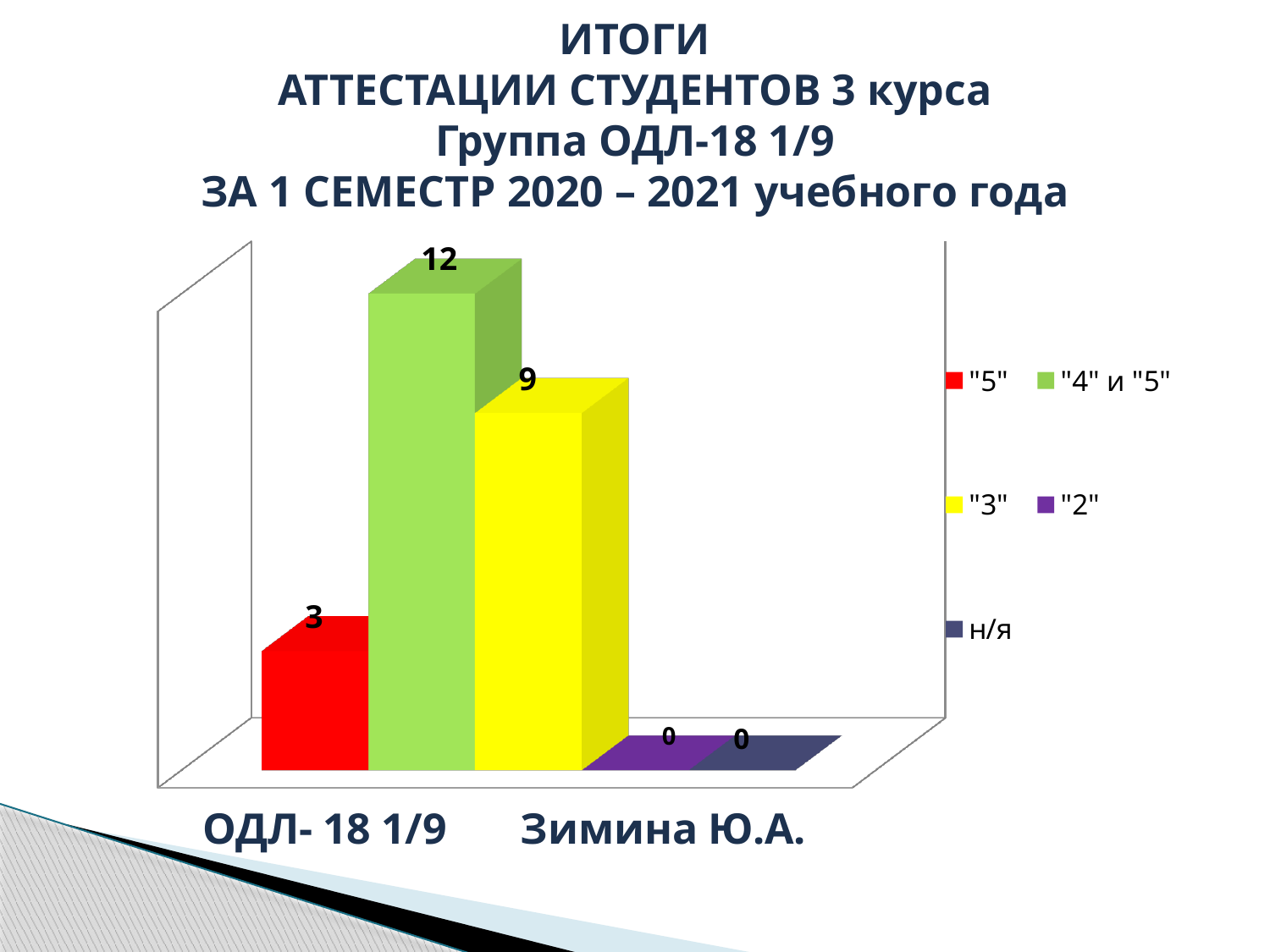
What kind of chart is shown on the slide? bar chart Which is larger, the value for "5" or the value for "3"? "3" How many series does the legend list? 5 What value is shown for the н/я series? 0 What value is shown for the "4" и "5" series? 12 What is the difference between the "3" value and the "5" value? 6 What value is shown for the "3" series? 9 What value is shown for the "5" series? 3 What colour is the bar for the "3" series? yellow What value is shown for the "2" series? 0 Which series has the highest value? "4" и "5" What is the difference between the "4" и "5" value and the "3" value? 3